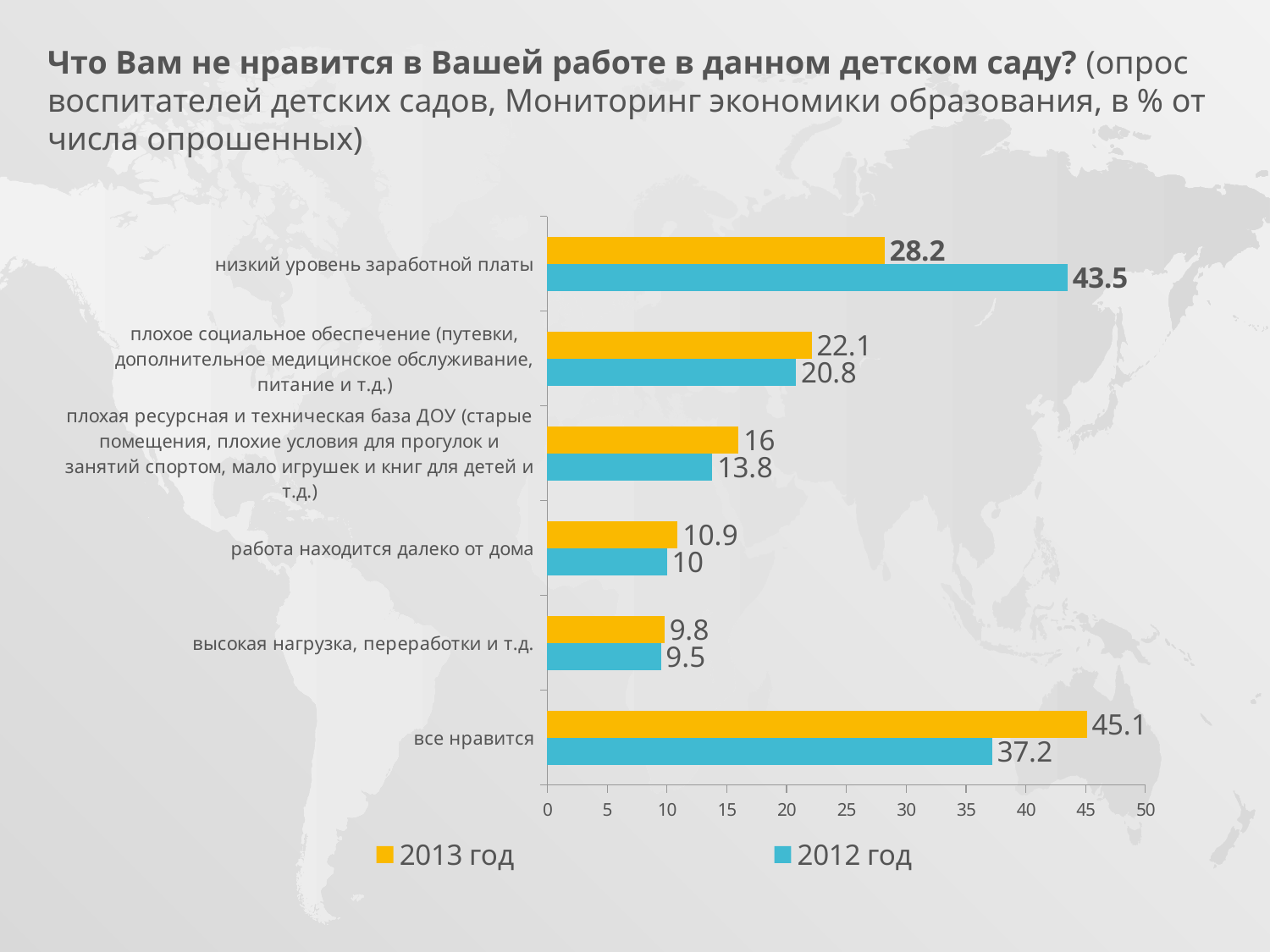
What is the value for "все нравится" in the 2013 год series? 45.1 For "все нравится", which series has the larger value, 2013 год or 2012 год? 2013 год How many categories are shown on the chart? 6 How many series does the legend list? 2 What is the value for "работа находится далеко от дома" in the 2012 год series? 10 What kind of chart is shown on the slide? bar chart What is the value for "низкий уровень заработной платы" in the 2012 год series? 43.5 Which colour represents the 2012 год series? blue Which category has the lowest value in the 2013 год series? высокая нагрузка, переработки и т.д. Is the 2013 год value for "плохое социальное обеспечение (путевки, дополнительное медицинское обслуживание, питание и т.д.)" greater or less than 20? greater Which category has the highest value in the 2012 год series? низкий уровень заработной платы What is the difference between the 2012 год and 2013 год values for "низкий уровень заработной платы"? 15.3